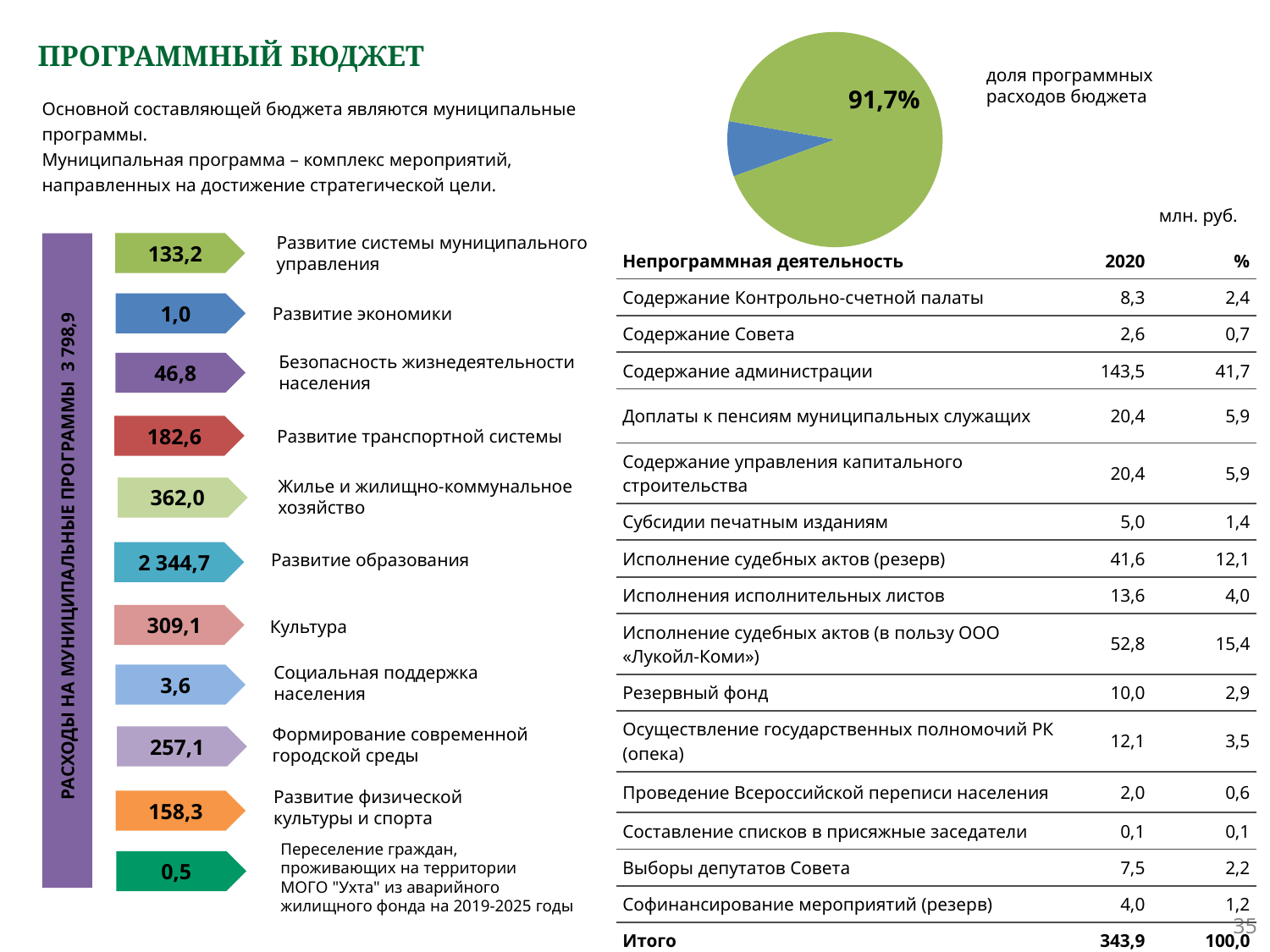
In the arrow diagram of municipal programs on the left, what is the difference between the values for Жилье и жилищно-коммунальное хозяйство and Культура? 52,9 In the arrow diagram of municipal programs on the left, which program has the lowest value? Переселение граждан, проживающих на территории МОГО "Ухта" из аварийного жилищного фонда на 2019-2025 годы In the pie chart at the top right, which slice is larger, the green one or the blue one? the green one In the arrow diagram of municipal programs on the left, how many programs are listed? 11 In the arrow diagram of municipal programs on the left, which program has the highest value? Развитие образования How many slices does the pie chart at the top right have? 2 What kind of chart is shown at the top right of the slide? pie chart In the pie chart at the top right, what share is printed on the green slice? 91,7% In the arrow diagram of municipal programs on the left, what value is shown for Развитие образования? 2 344,7 What does the pie chart at the top right represent, according to the caption next to it? доля программных расходов бюджета In the arrow diagram of municipal programs on the left, what value is shown for Культура? 309,1 In the arrow diagram of municipal programs on the left, which is larger: Развитие транспортной системы or Развитие физической культуры и спорта? Развитие транспортной системы